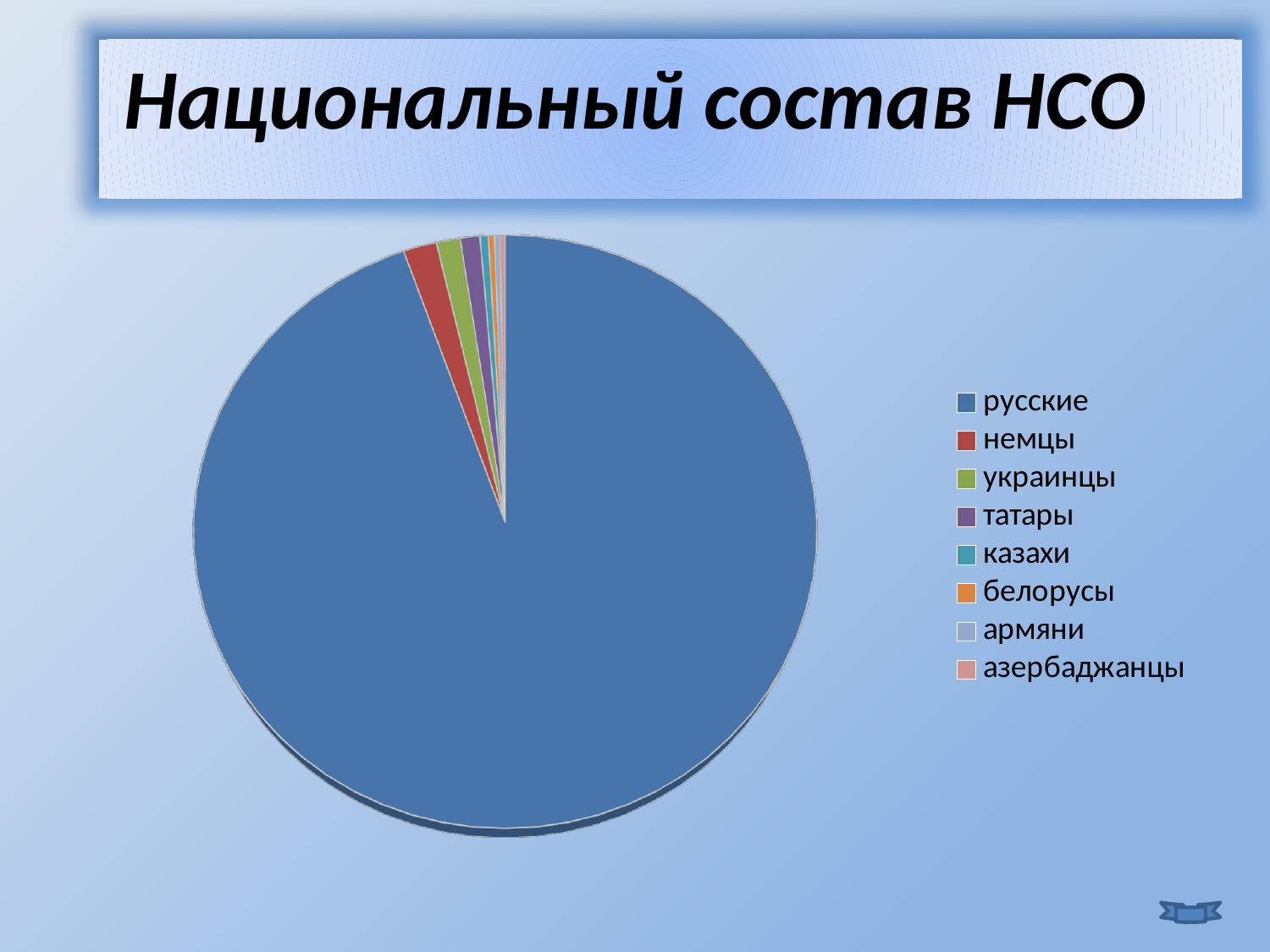
Which category has the largest slice of the pie chart? русские Which category is listed first in the legend of the pie chart? русские What kind of chart is shown on the slide? pie chart Which slice is larger, татары or русские? русские Which slice is larger, немцы or казахи? немцы What is the title of the slide with the pie chart? Национальный состав НСО How many categories does the pie chart show? 8 Which category is listed last in the legend of the pie chart? азербаджанцы Which slice is larger, русские or немцы? русские